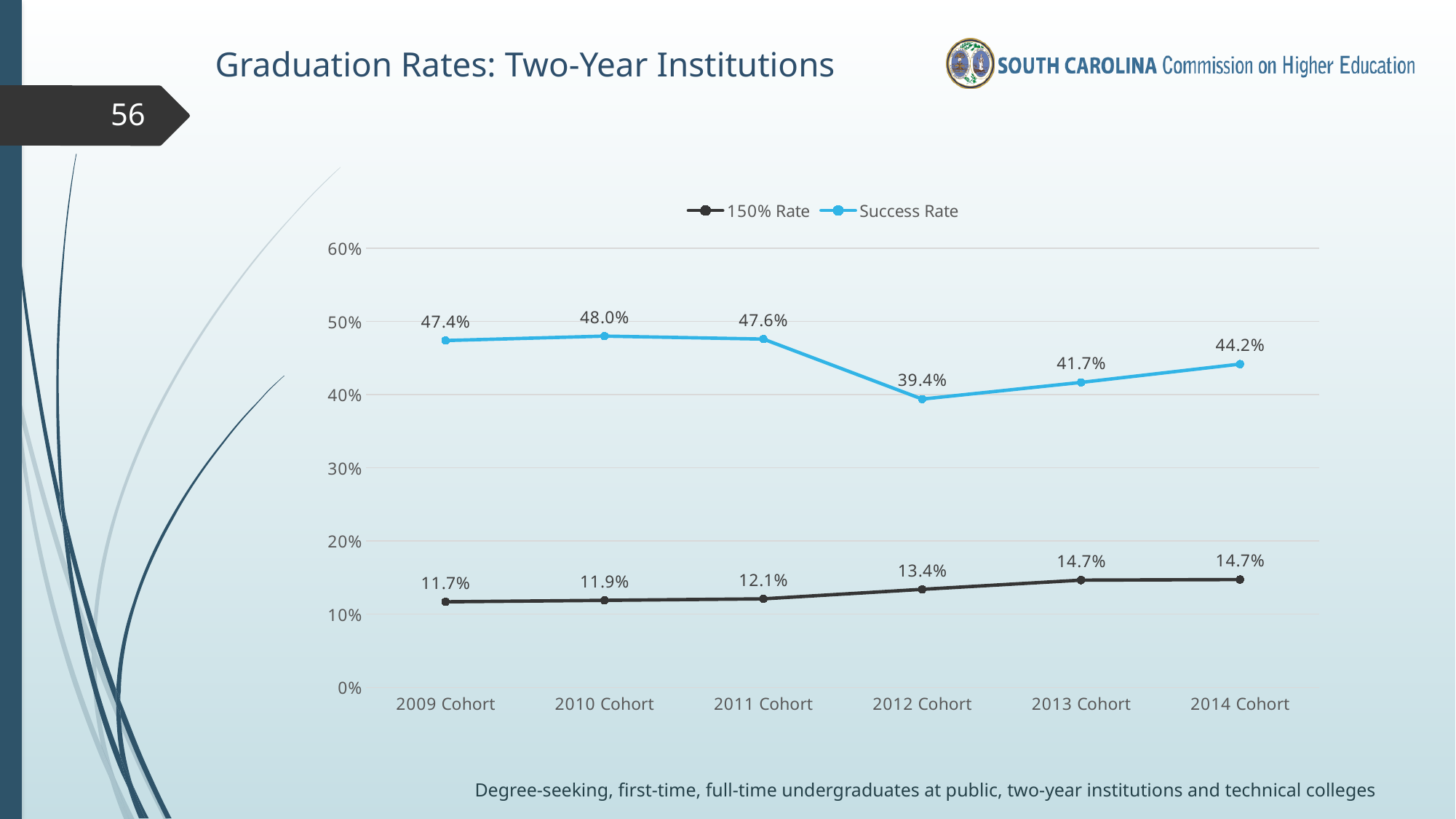
How many series does the legend list? 2 Which cohort has the lowest 150% Rate? 2009 Cohort What is the 150% Rate for the 2014 Cohort? 14.7% Which cohort has the lowest Success Rate? 2012 Cohort What is the difference between the Success Rate and the 150% Rate for the 2014 Cohort? 29.5% What type of chart is shown on the slide? line chart Is the Success Rate for the 2013 Cohort higher or lower than for the 2012 Cohort? higher Which cohort has the highest Success Rate? 2010 Cohort What is the 150% Rate for the 2009 Cohort? 11.7% Does the 150% Rate rise or fall from the 2009 Cohort to the 2014 Cohort? rise How many cohorts are shown on the x axis? 6 What is the Success Rate for the 2012 Cohort? 39.4%